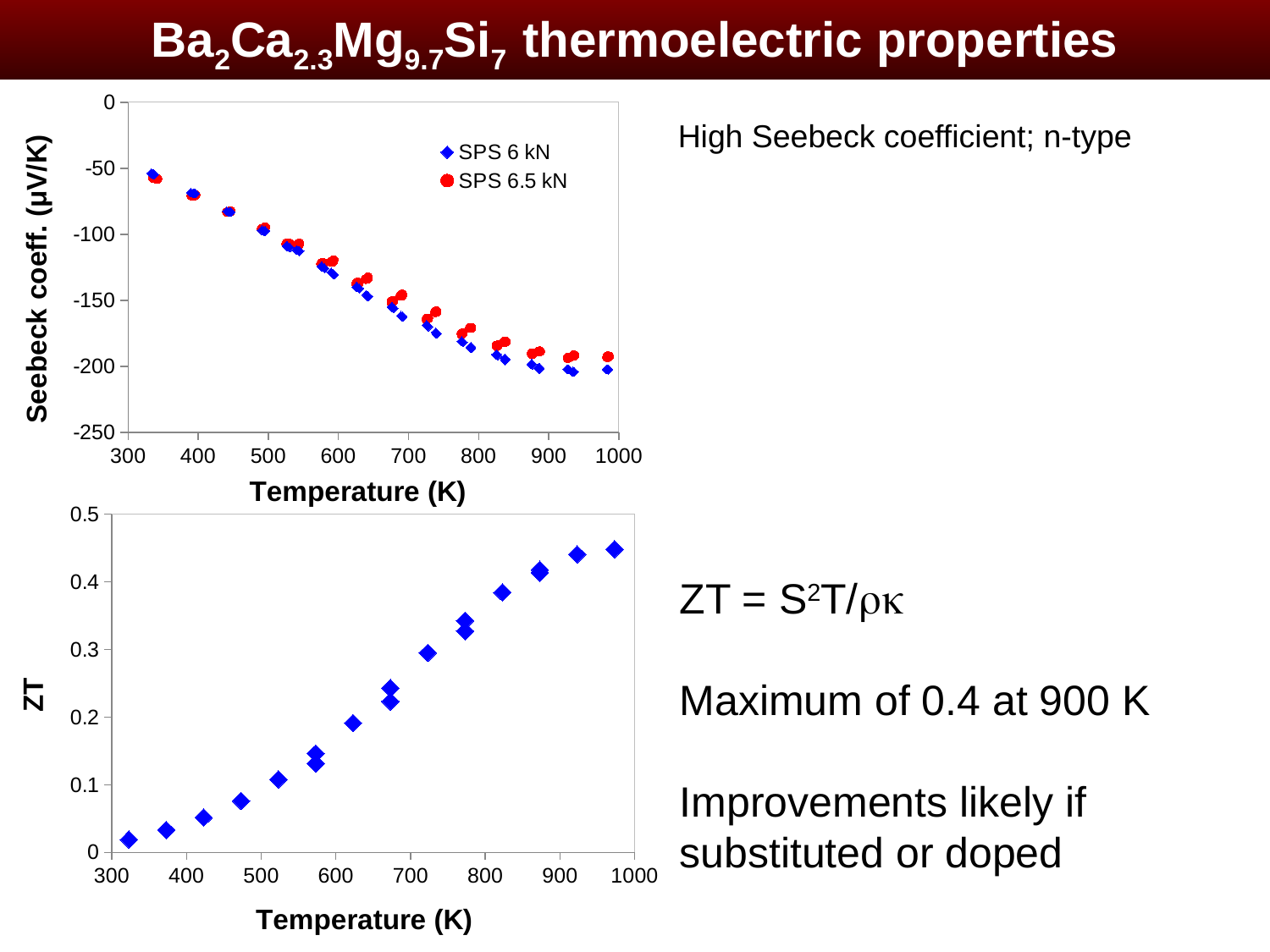
In the top Seebeck coefficient chart, what are the two series named in the legend? SPS 6 kN and SPS 6.5 kN In the bottom ZT chart, is the ZT value at around 525 K greater or less than 0.2? less In the bottom ZT chart, is the ZT value at around 975 K greater or less than 0.4? greater How many series does the legend of the top Seebeck coefficient chart list? 2 In the top Seebeck coefficient chart, at around 950 K, which series has the higher (less negative) Seebeck coefficient, SPS 6 kN or SPS 6.5 kN? SPS 6.5 kN In the top Seebeck coefficient chart, is the value for SPS 6 kN at around 900 K greater or less than -150? less In the bottom ZT chart, does ZT rise or fall as temperature increases? Rise What kind of chart is the top chart showing Seebeck coefficient versus temperature? Scatter chart In the top Seebeck coefficient chart, does the Seebeck coefficient rise or fall as temperature increases? Fall What is the y-axis title of the top chart? Seebeck coeff. (μV/K) What kind of chart is the bottom chart showing ZT versus temperature? Scatter chart